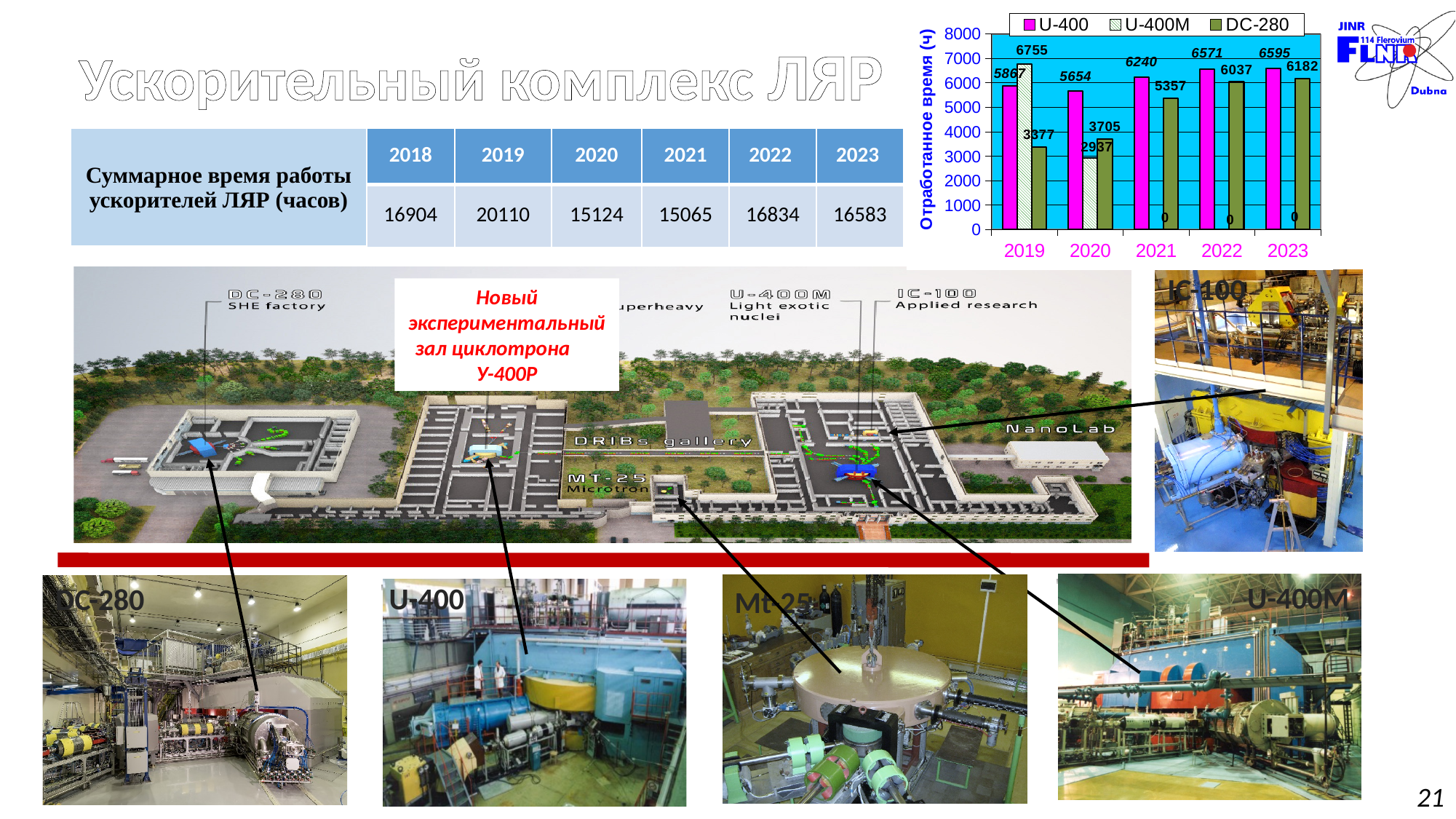
What is the value for U-400 in 2019? 5867 What is the value for U-400M in 2019? 6755 What kind of chart is shown on the slide? bar chart How many series does the chart legend list? 3 What is the value for U-400M in 2021? 0 Is the value for DC-280 in 2021 greater or less than 5000? greater What is the value for DC-280 in 2020? 3705 In which year is the DC-280 value lowest? 2019 How many years are shown on the x axis of the chart? 5 What is the difference between the U-400 and DC-280 values in 2023? 413 In which year is the U-400 value highest? 2023 Which is larger in 2020, the U-400M value or the DC-280 value? DC-280